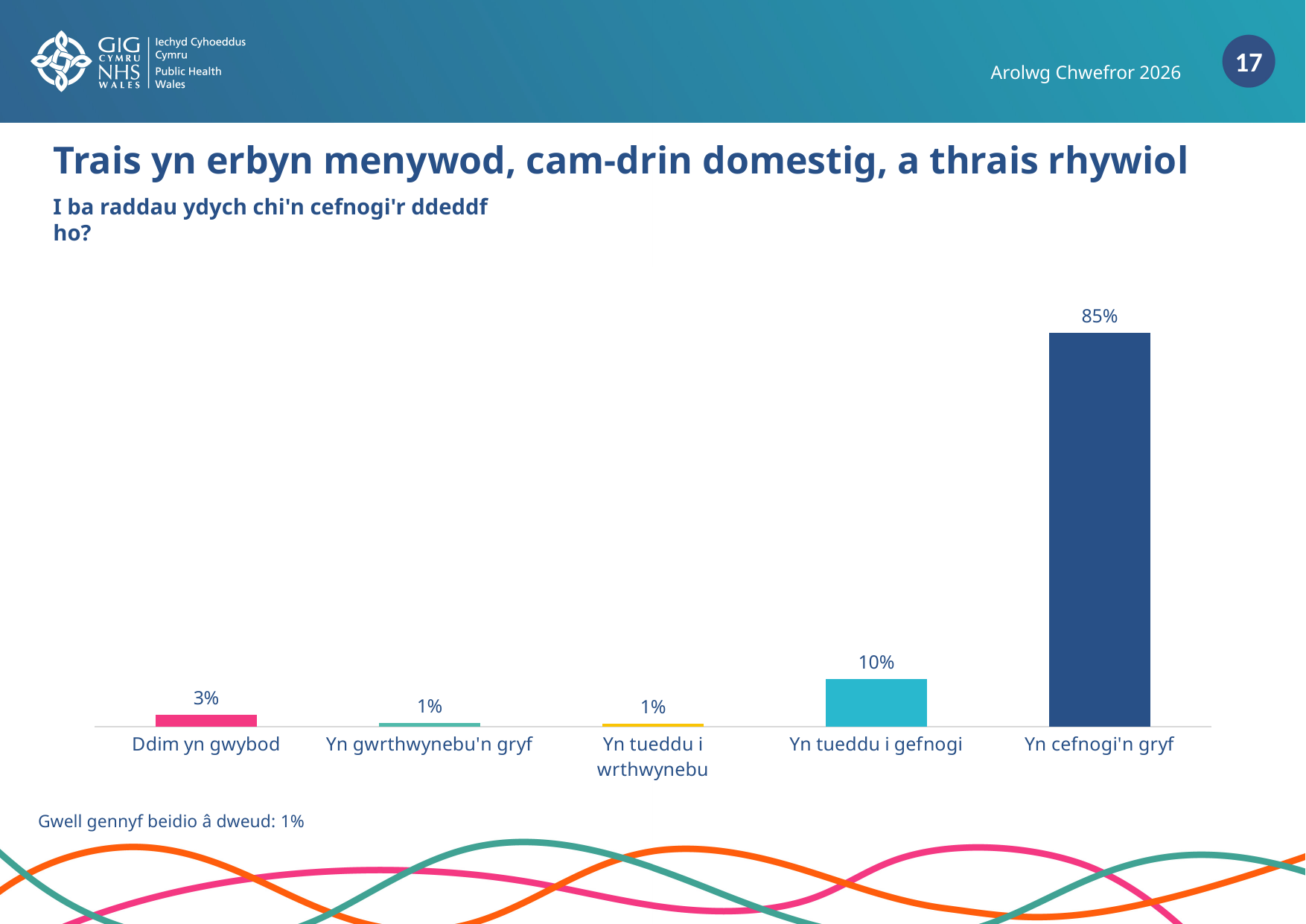
How many categories are shown on the x axis of the chart? 5 What percentage is given for 'Gwell gennyf beidio â dweud' in the note below the chart? 1% What kind of chart is shown on the slide? Bar chart What is the difference between 'Yn cefnogi'n gryf' and 'Yn tueddu i gefnogi'? 75% What is the value for 'Yn cefnogi'n gryf'? 85% What is the combined value of 'Yn tueddu i gefnogi' and 'Yn cefnogi'n gryf'? 95% What is the difference between 'Yn tueddu i gefnogi' and 'Ddim yn gwybod'? 7% What is the value for 'Ddim yn gwybod'? 3% Which is larger, 'Ddim yn gwybod' or 'Yn tueddu i wrthwynebu'? Ddim yn gwybod Which category has the highest value? Yn cefnogi'n gryf What is the value for 'Yn tueddu i gefnogi'? 10% What is the value for 'Yn gwrthwynebu'n gryf'? 1%